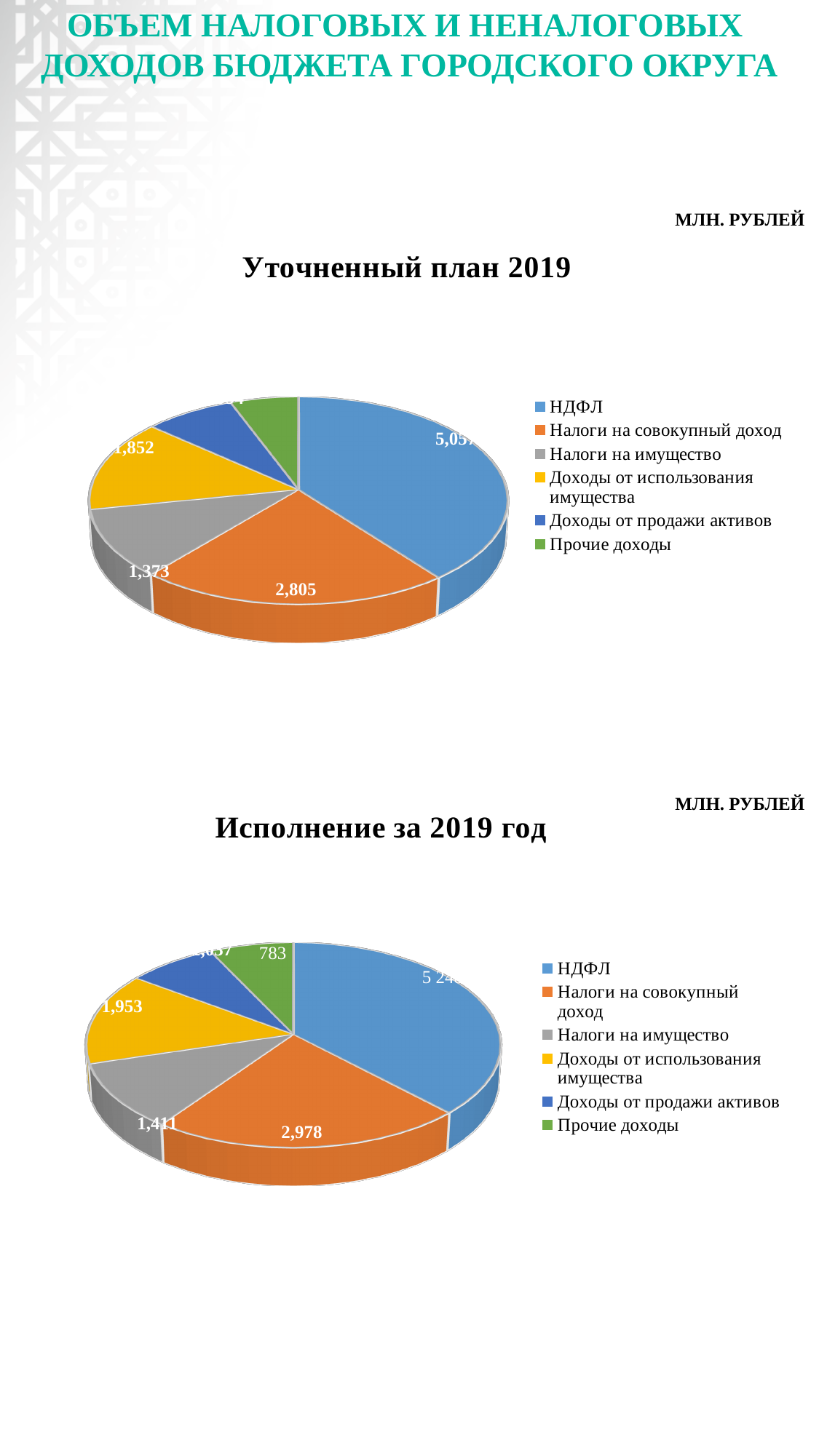
In the 'Исполнение за 2019 год' chart, what is the value for Прочие доходы? 783 In the 'Уточненный план 2019' chart, what is the value for Налоги на имущество? 1,373 In the 'Исполнение за 2019 год' chart, what is the value for Доходы от использования имущества? 1,953 In the 'Уточненный план 2019' chart, what is the difference between Налоги на совокупный доход and Налоги на имущество? 1,432 In the 'Исполнение за 2019 год' chart, which is larger: Доходы от использования имущества or Налоги на имущество? Доходы от использования имущества In the 'Уточненный план 2019' chart, which category has the largest slice? НДФЛ What type of chart is the 'Уточненный план 2019' chart? Pie chart In the 'Исполнение за 2019 год' chart, what is the value for Налоги на совокупный доход? 2,978 In the 'Уточненный план 2019' chart, what is the value for Налоги на совокупный доход? 2,805 How many categories does the 'Исполнение за 2019 год' chart show? 6 In the 'Уточненный план 2019' chart, what is the value for Доходы от использования имущества? 1,852 In the 'Исполнение за 2019 год' chart, which category has the smallest slice? Прочие доходы